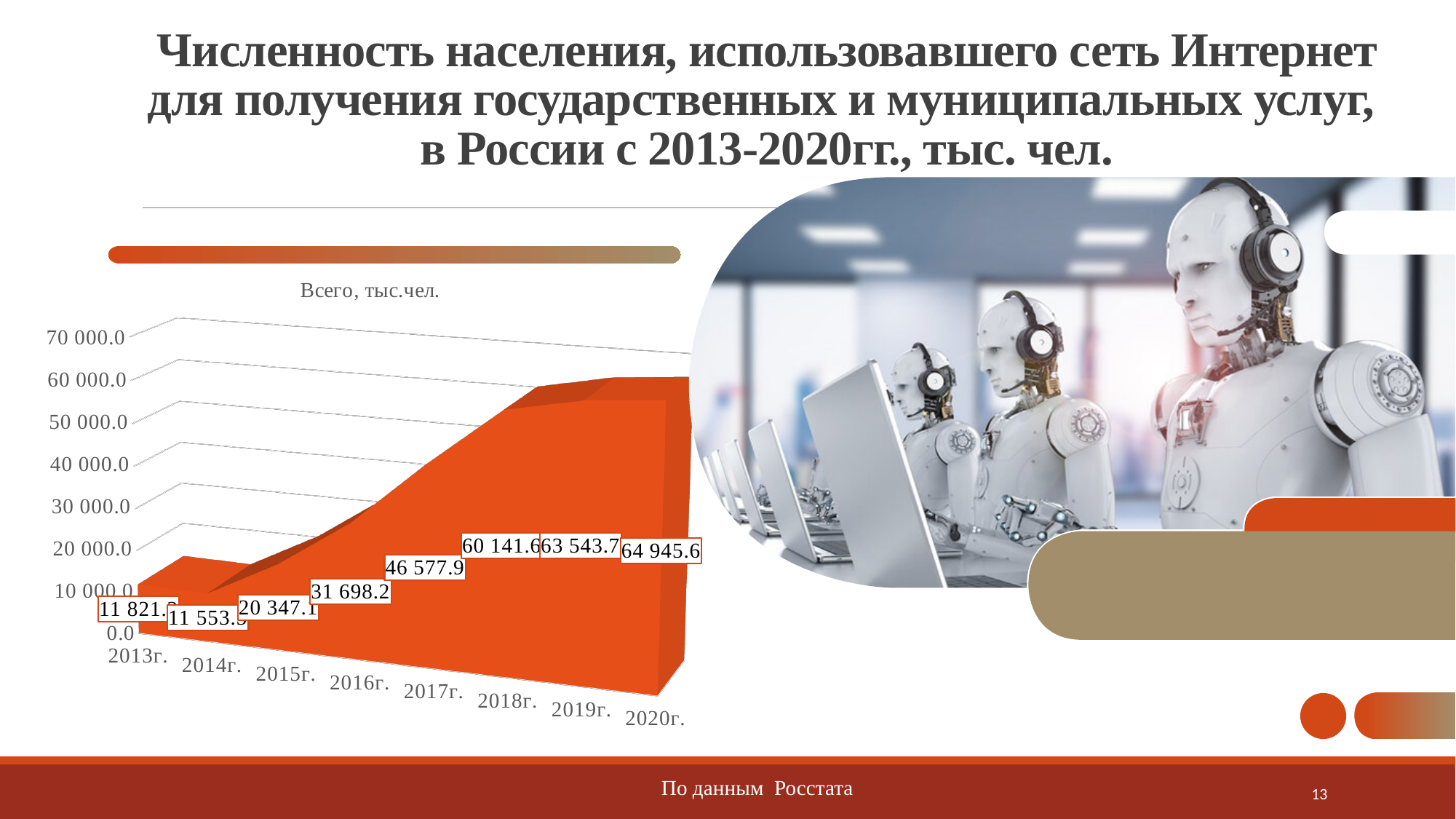
What is the difference between the values for 2017г. and 2016г.? 14 879.7 What kind of chart is this? area chart What is the difference between the values for 2020г. and 2019г.? 1 401.9 How many years are shown on the x axis? 8 What is the value for 2016г.? 31 698.2 What is the value for 2019г.? 63 543.7 What is the value for 2015г.? 20 347.1 What is the value for 2017г.? 46 577.9 Which year has the highest value? 2020г. What is the value for 2018г.? 60 141.6 Which is larger, the value for 2018г. or for 2017г.? 2018г. What is the value for 2020г.? 64 945.6